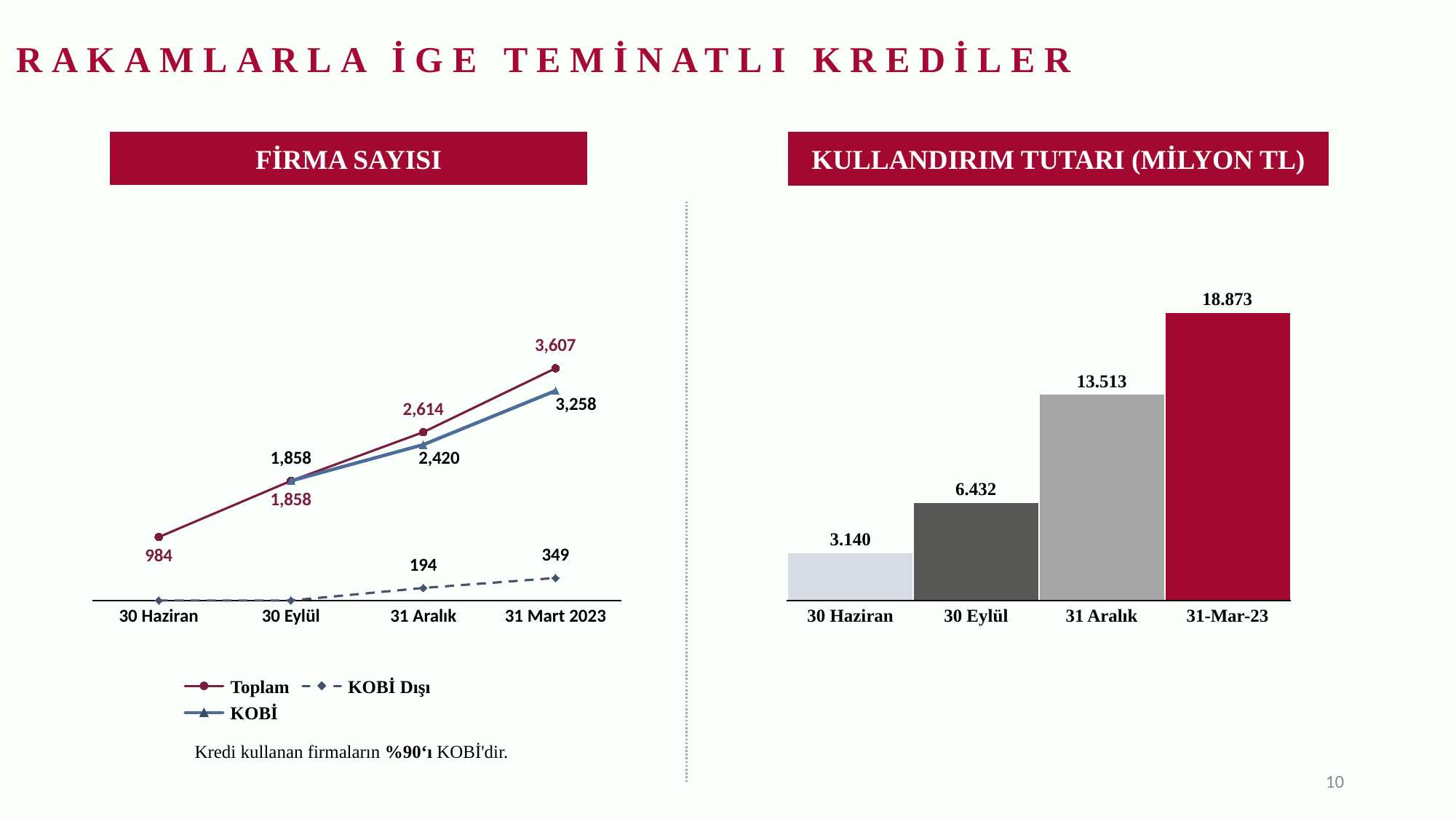
What kind of chart is the KULLANDIRIM TUTARI (MİLYON TL) chart? bar chart In the FİRMA SAYISI chart, what is the Toplam value for 31 Mart 2023? 3,607 In the KULLANDIRIM TUTARI (MİLYON TL) chart, which category has the lowest value? 30 Haziran In the FİRMA SAYISI chart, what is the difference between the Toplam and KOBİ values for 31 Mart 2023? 349 In the FİRMA SAYISI chart, how many series does the legend list? 3 In the KULLANDIRIM TUTARI (MİLYON TL) chart, what is the value for 30 Eylül? 6.432 In the KULLANDIRIM TUTARI (MİLYON TL) chart, which is larger, the value for 31 Aralık or the value for 30 Eylül? 31 Aralık In the FİRMA SAYISI chart, does the Toplam series rise or fall from 30 Haziran to 31 Mart 2023? rise In the FİRMA SAYISI chart, what is the KOBİ value for 31 Aralık? 2,420 In the KULLANDIRIM TUTARI (MİLYON TL) chart, which category has the highest value? 31-Mar-23 In the FİRMA SAYISI chart, what is the KOBİ Dışı value for 31 Mart 2023? 349 In the KULLANDIRIM TUTARI (MİLYON TL) chart, how many bars are there? 4